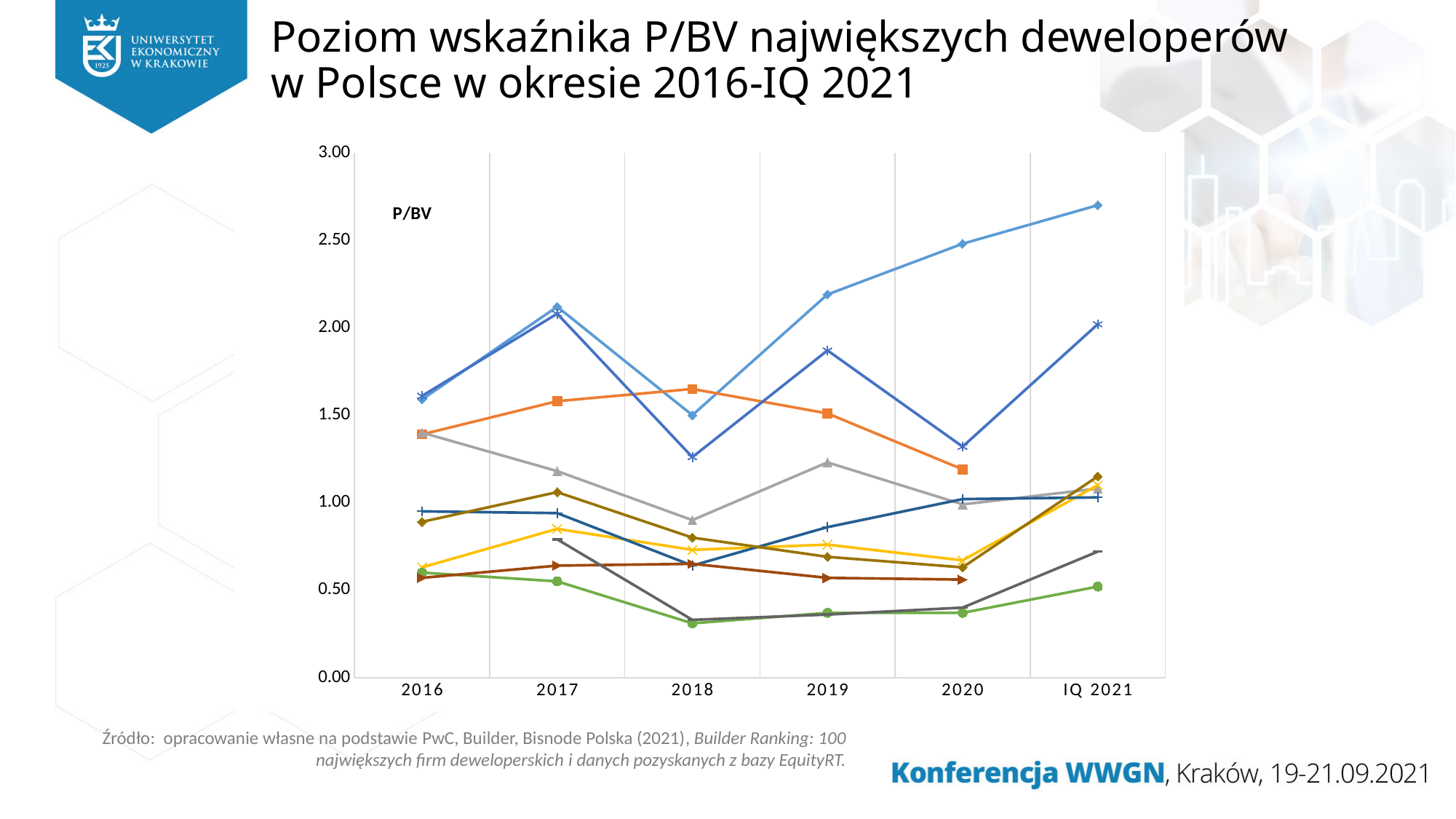
Does the highest plotted value rise or fall from 2018 to IQ 2021? rise Is the lowest value plotted for 2018 greater or less than 0.50? less What kind of chart is shown on the slide? line chart Is the highest value plotted for 2018 greater or less than 2.00? less Is the lowest value plotted for 2016 greater or less than 1.00? less What is the title of the chart on the slide? Poziom wskaźnika P/BV największych deweloperów w Polsce w okresie 2016-IQ 2021 How many periods are shown on the x axis of the chart? 6 Which period on the x axis contains the highest plotted value in the chart? IQ 2021 What label is printed inside the plot area near the top of the y axis? P/BV